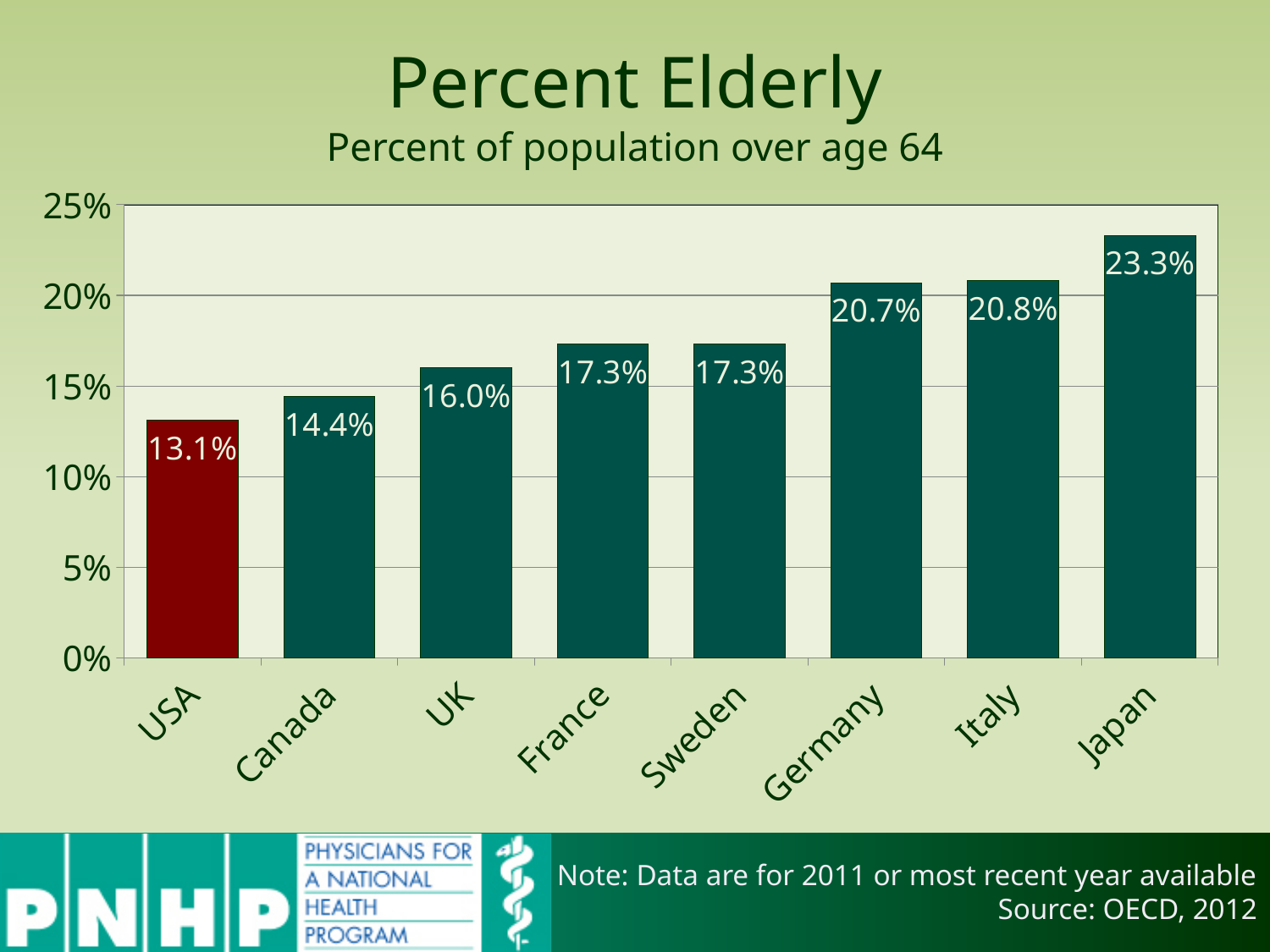
What is the percent elderly value for the USA? 13.1% What is the percent elderly value for the UK? 16.0% What is the percent elderly value for Germany? 20.7% What kind of chart is shown on the slide? Bar chart Which country has the highest percent elderly? Japan How many countries are shown in the chart? 8 Is the value for Italy greater or less than 20%? greater What is the difference between Japan's and the USA's percent elderly values? 10.2% Which bar is coloured differently from the others? USA Which country has the lowest percent elderly? USA What is the difference between Canada's and the USA's percent elderly values? 1.3% Which has a higher percent elderly, Canada or the UK? UK